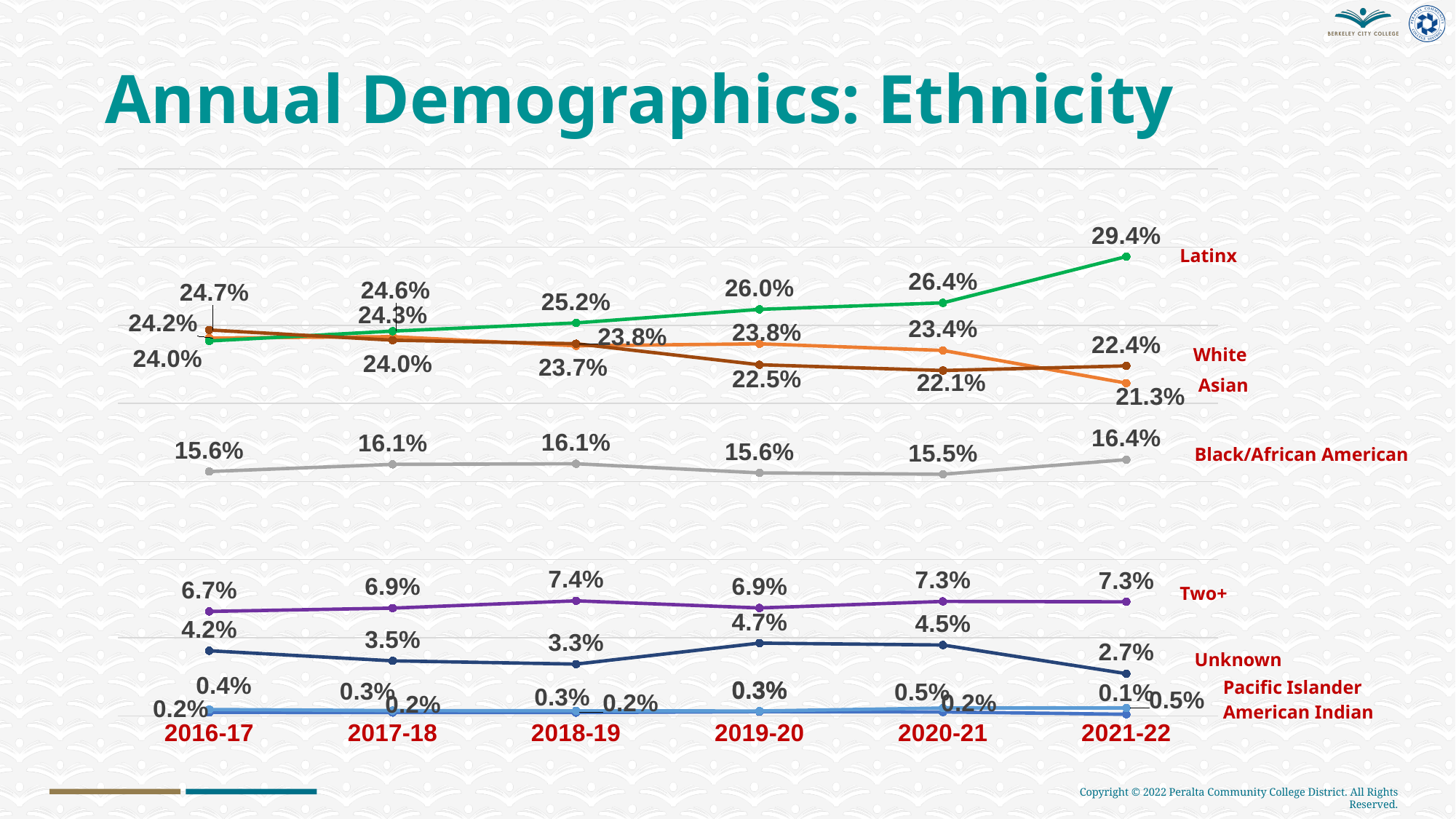
How many ethnicity groups are labeled on the chart? 8 Does the Latinx line rise or fall from 2016-17 to 2021-22? Rises What is the Unknown value for 2019-20? 4.7% Which ethnicity group has the highest value in 2021-22? Latinx What is the Latinx value for 2021-22? 29.4% Which is larger in 2019-20, the Two+ value or the Unknown value? Two+ In which year is the Black/African American value lowest? 2020-21 What kind of chart is shown on the slide? Line chart How many academic years are shown on the x axis? 6 What is the Two+ value for 2018-19? 7.4% By how many percentage points did the Latinx value change from 2020-21 to 2021-22? 3.0 percentage points What is the Black/African American value for 2021-22? 16.4%